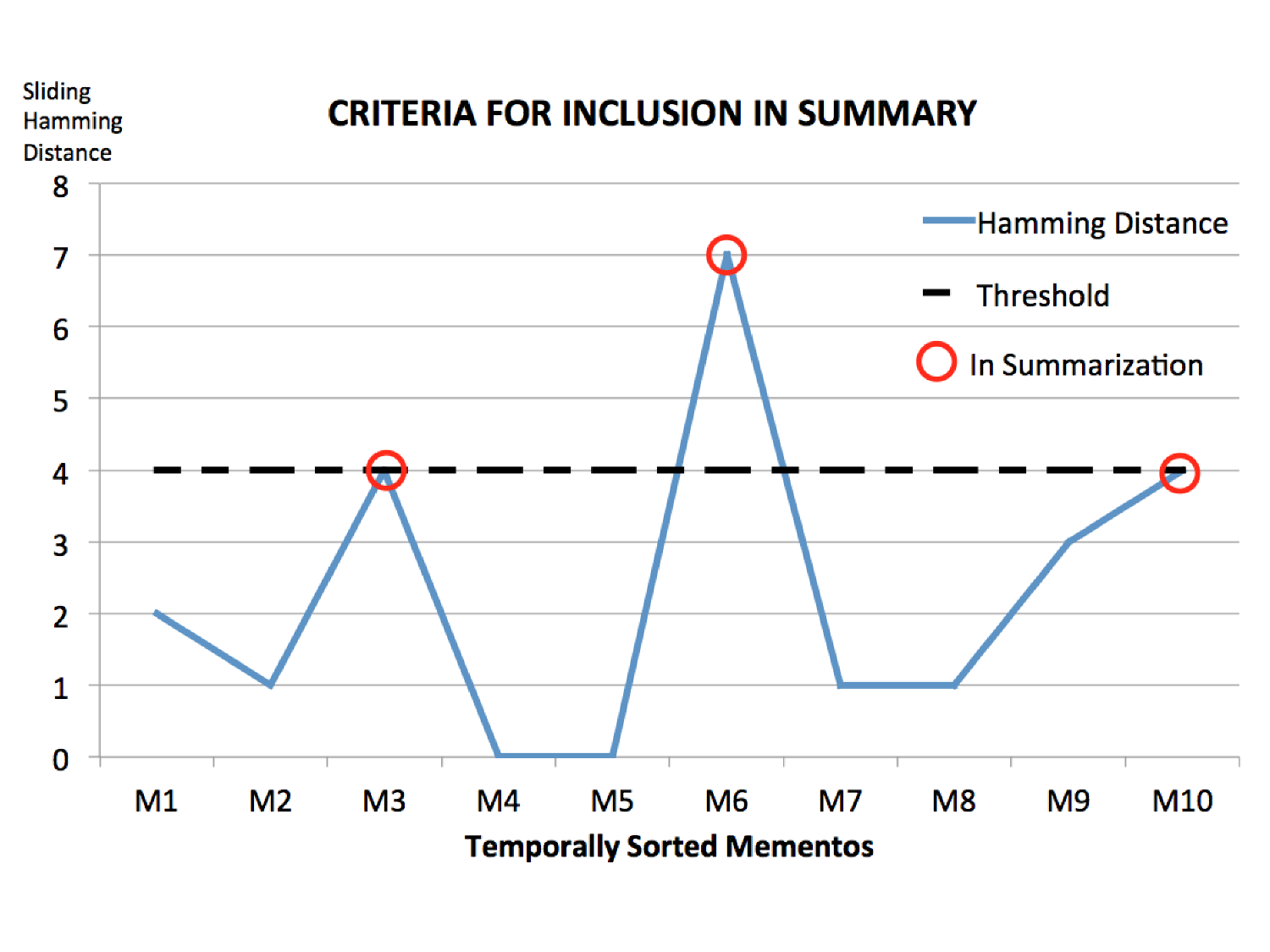
What is the Hamming Distance for M9? 3 How many entries does the legend list? 3 Does the Hamming Distance rise or fall from M6 to M7? Fall What is the Hamming Distance for M1? 2 Which has a larger Hamming Distance, M2 or M9? M9 What is the title of the chart? CRITERIA FOR INCLUSION IN SUMMARY At what value is the Threshold line drawn? 4 How many mementos are plotted along the x axis? 10 What is the difference between the Hamming Distance at M6 and at M3? 3 What type of chart is shown on the slide? Line chart What is the Hamming Distance for M6? 7 Which memento has the highest Hamming Distance? M6